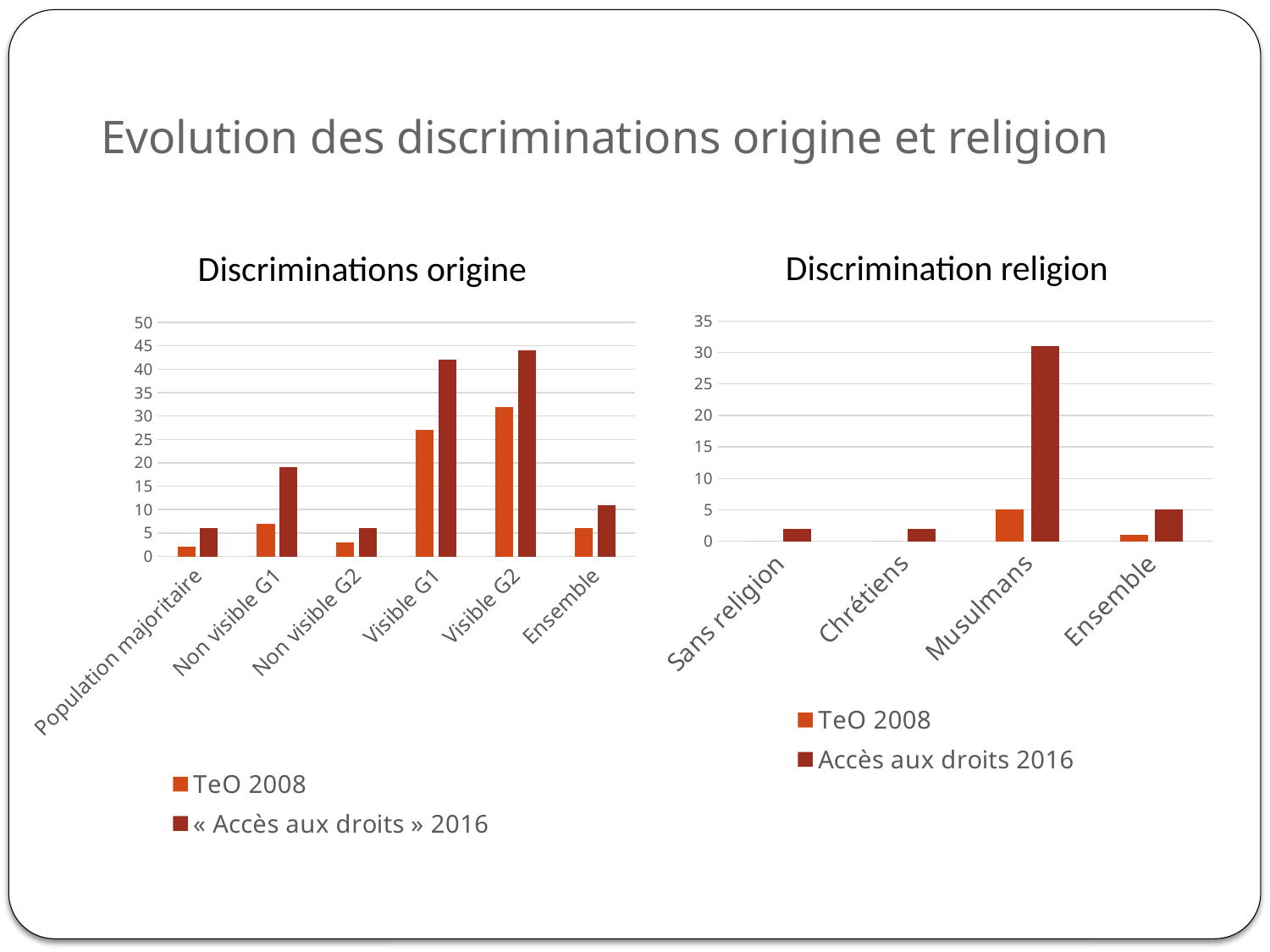
In the 'Discriminations origine' chart, how many categories are shown on the x axis? 6 In the 'Discrimination religion' chart, is the value for Musulmans in Accès aux droits 2016 greater or less than 25? greater In the 'Discriminations origine' chart, how many series does the legend list? 2 In the 'Discrimination religion' chart, what are the two legend entries? TeO 2008 and Accès aux droits 2016 In the 'Discriminations origine' chart, which is larger for TeO 2008: Visible G1 or Non visible G1? Visible G1 In the 'Discriminations origine' chart, which category has the highest value for TeO 2008? Visible G2 In the 'Discrimination religion' chart, which is larger for TeO 2008: Musulmans or Ensemble? Musulmans In the 'Discrimination religion' chart, how many categories are shown on the x axis? 4 In the 'Discriminations origine' chart, is the value for Non visible G1 in « Accès aux droits » 2016 greater or less than 15? greater In the 'Discrimination religion' chart, which category has the highest value for Accès aux droits 2016? Musulmans In the 'Discriminations origine' chart, what kind of chart is shown? bar chart In the 'Discriminations origine' chart, is the value for Visible G1 in « Accès aux droits » 2016 greater or less than 40? greater